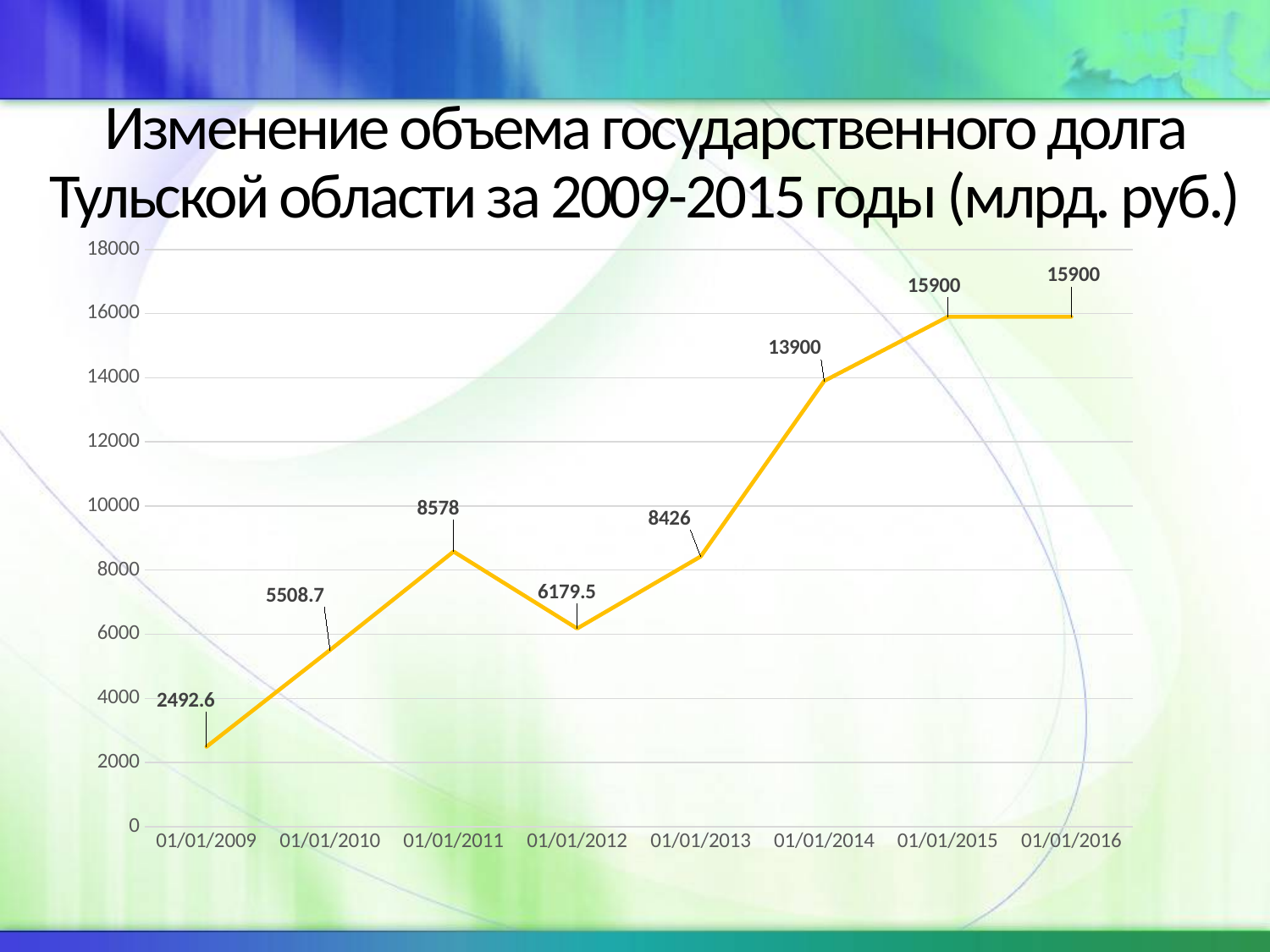
Which is larger, the value for 01/01/2011 or the value for 01/01/2013? 01/01/2011 What is the difference between the values for 01/01/2015 and 01/01/2014? 2000 What is the value for 01/01/2012? 6179.5 What is the value for 01/01/2009? 2492.6 Which date has the lowest value? 01/01/2009 What is the overall trend of the values from 01/01/2009 to 01/01/2016? rising What is the difference between the values for 01/01/2011 and 01/01/2012? 2398.5 How many data points are plotted on the chart? 8 What is the value for 01/01/2011? 8578 What is the highest value shown on the chart? 15900 What type of chart is shown on the slide? line chart What is the value for 01/01/2014? 13900